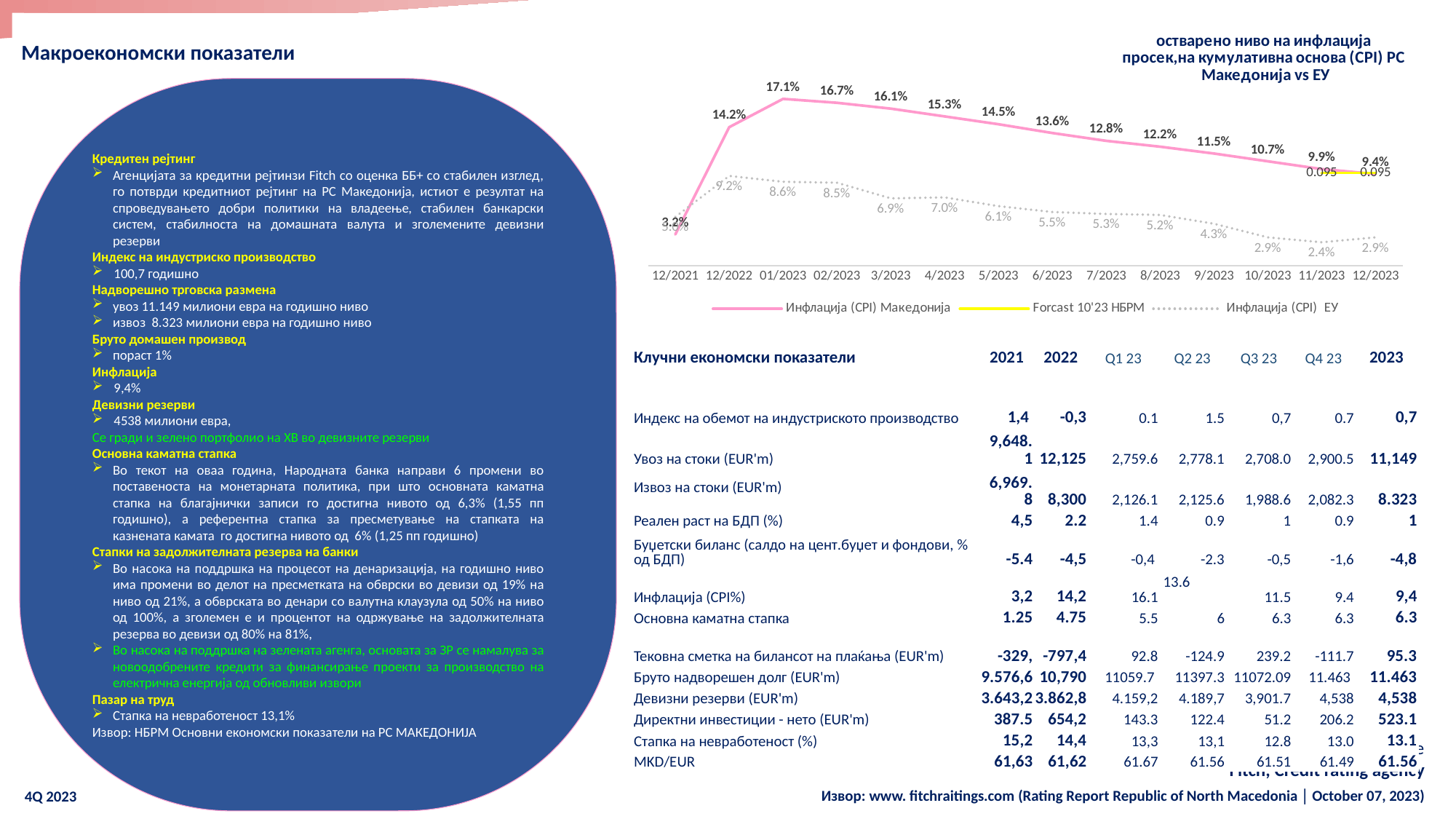
What is the value of Инфлација (CPI) Македонија for 01/2023? 17.1% How many dates are shown on the x axis of the chart? 14 How many series does the chart legend list? 3 What is the value of Инфлација (CPI) ЕУ for 11/2023? 2.4% What is the value of Инфлација (CPI) ЕУ for 12/2022? 9.2% What is the difference between Инфлација (CPI) Македонија in 01/2023 and 12/2023? 7.7% What is the value of Инфлација (CPI) Македонија for 12/2023? 9.4% At which date is Инфлација (CPI) Македонија lowest? 12/2021 What type of chart is shown on the slide? line chart Does Инфлација (CPI) Македонија rise or fall from 01/2023 to 12/2023? fall At which date does Инфлација (CPI) Македонија reach its highest value? 01/2023 Which is larger in 6/2023: Инфлација (CPI) Македонија or Инфлација (CPI) ЕУ? Инфлација (CPI) Македонија